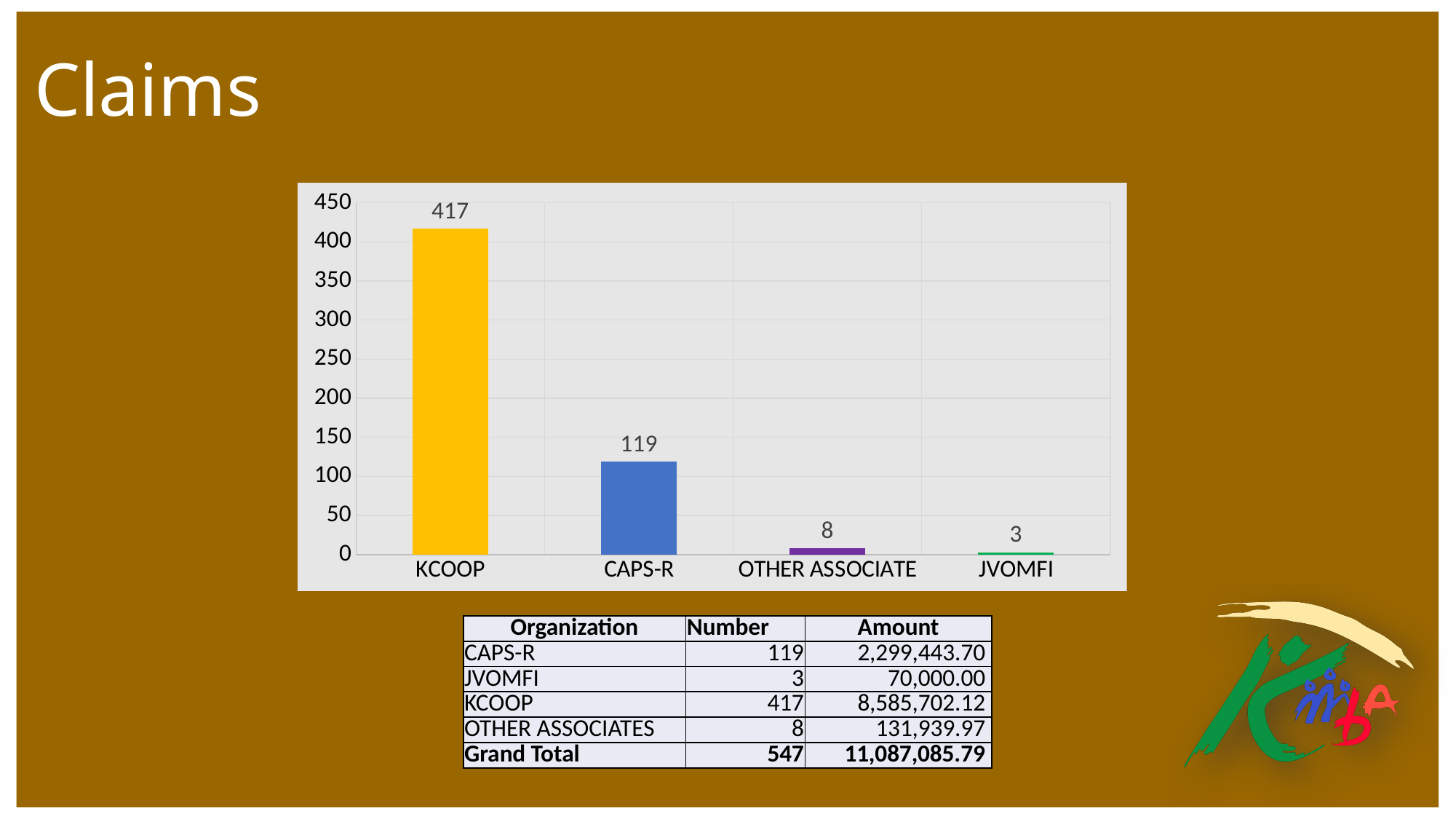
What is the difference between the values for OTHER ASSOCIATE and JVOMFI? 5 Which is larger, the value for CAPS-R or the value for OTHER ASSOCIATE? CAPS-R Which category has the lowest value? JVOMFI Which category has the highest value? KCOOP Is the value for KCOOP greater or less than 400? greater How many categories are shown on the chart? 4 What is the difference between the values for KCOOP and CAPS-R? 298 What is the value for OTHER ASSOCIATE? 8 What is the value for CAPS-R? 119 What kind of chart is shown on the slide? bar chart What is the value for JVOMFI? 3 What is the value for KCOOP? 417